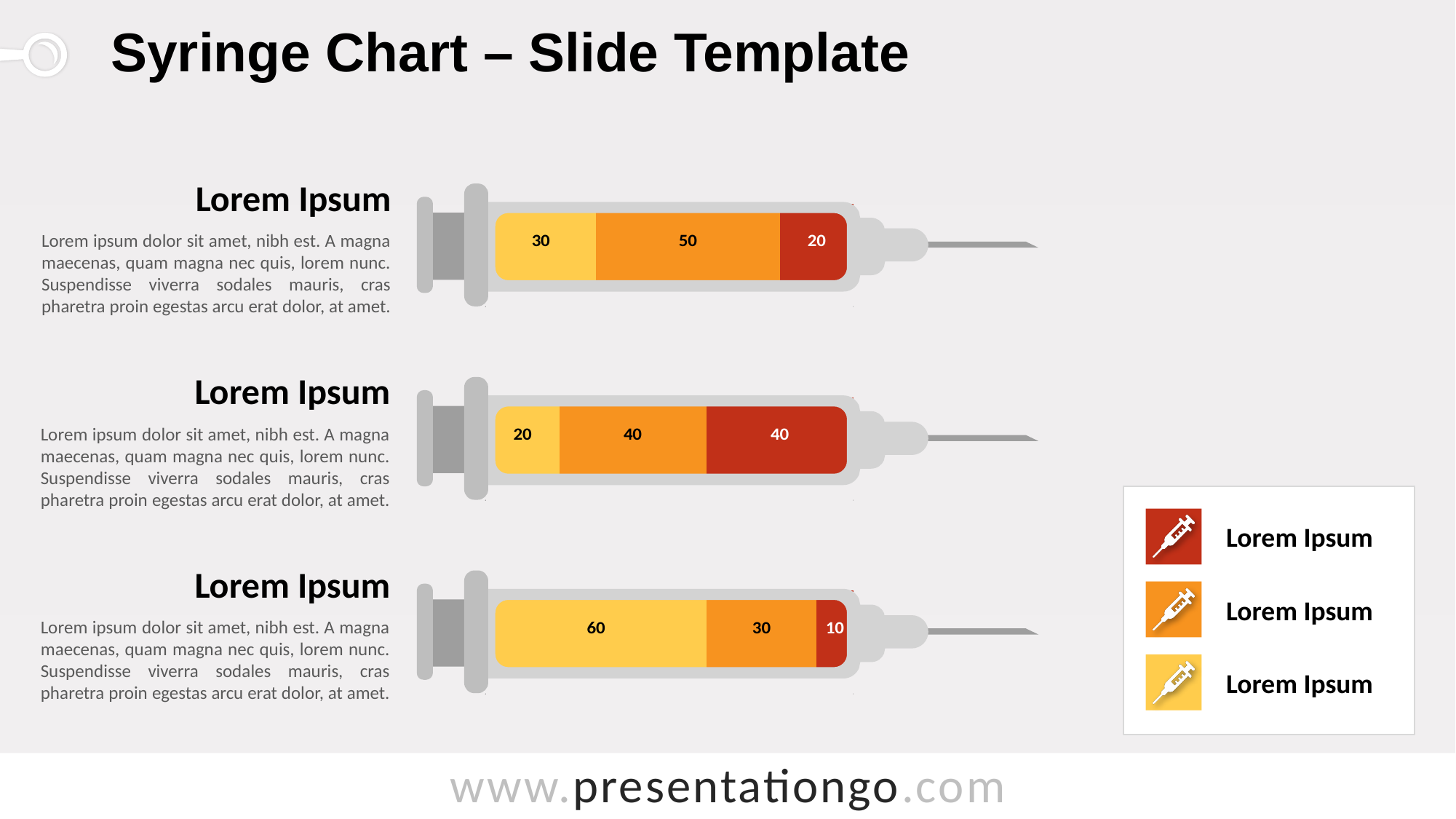
How many syringe bars are shown on the slide? 3 Is the yellow segment larger in the bottom syringe bar or in the middle syringe bar? The bottom syringe bar Which segment is the largest in the bottom syringe bar? The yellow segment (60) What is the value of the red segment in the bottom syringe bar? 10 What is the difference between the orange and yellow segments in the top syringe bar? 20 What is the value of the red segment in the middle syringe bar? 40 What is the value of the orange segment in the top syringe bar? 50 What is the total of the three segments in the top syringe bar? 100 What is the value of the yellow segment in the bottom syringe bar? 60 Which segment is the smallest in the top syringe bar? The red segment (20) What is the total of the three segments in the middle syringe bar? 100 What is the value of the yellow segment in the top syringe bar? 30